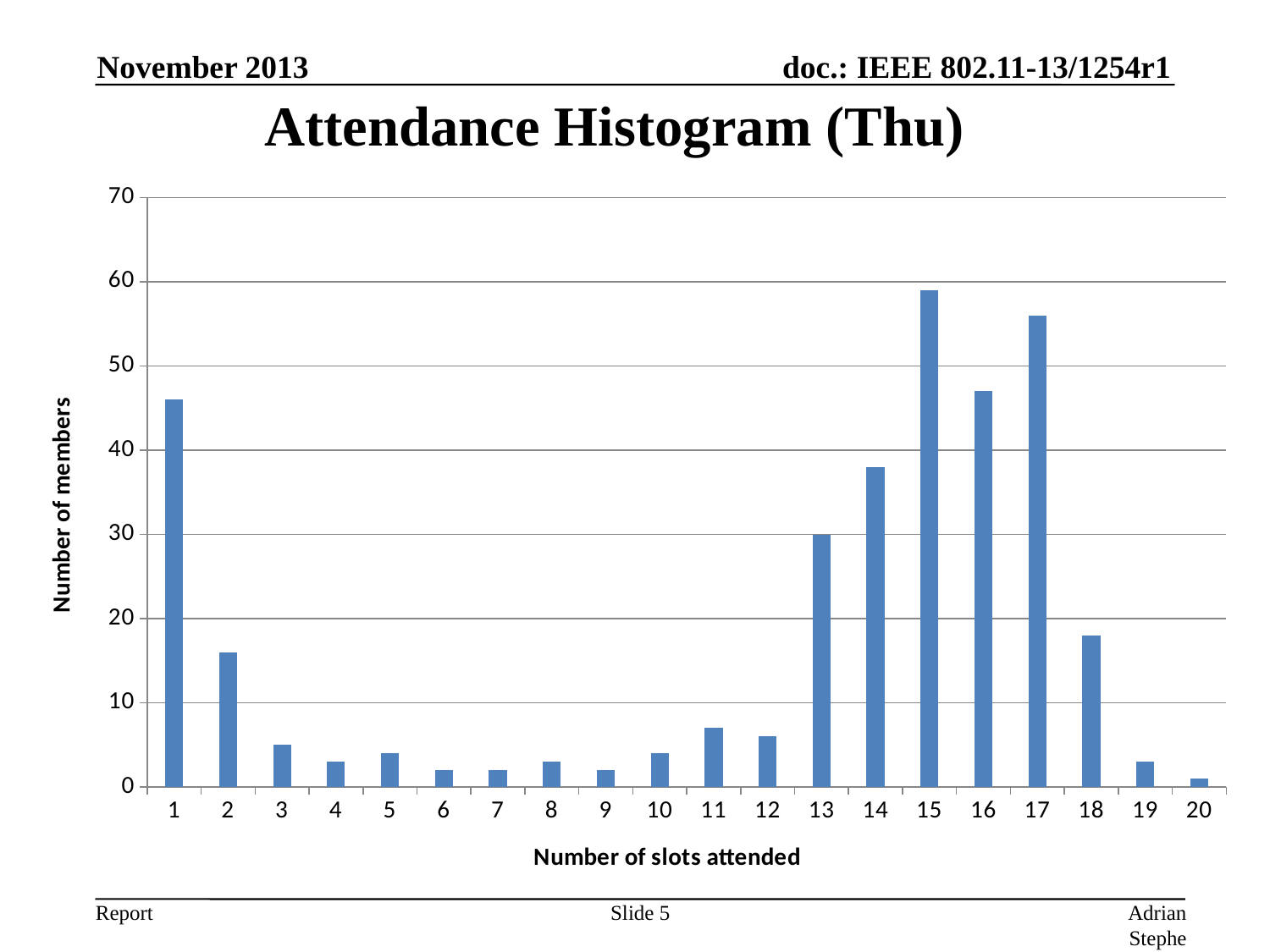
How many categories (number of slots attended) are shown on the x axis? 20 Which has more members: 13 slots attended or 14 slots attended? 14 What type of chart is shown on the slide? bar chart Is the number of members for 18 slots attended greater or less than 10? greater Which number of slots attended has the lowest number of members? 20 What is the label of the x axis? Number of slots attended Is the number of members for 1 slot attended greater or less than 40? greater Is the number of members for 15 slots attended greater or less than 50? greater Which number of slots attended has the highest number of members? 15 Which has more members: 14 slots attended or 16 slots attended? 16 What is the title of the chart? Attendance Histogram (Thu)